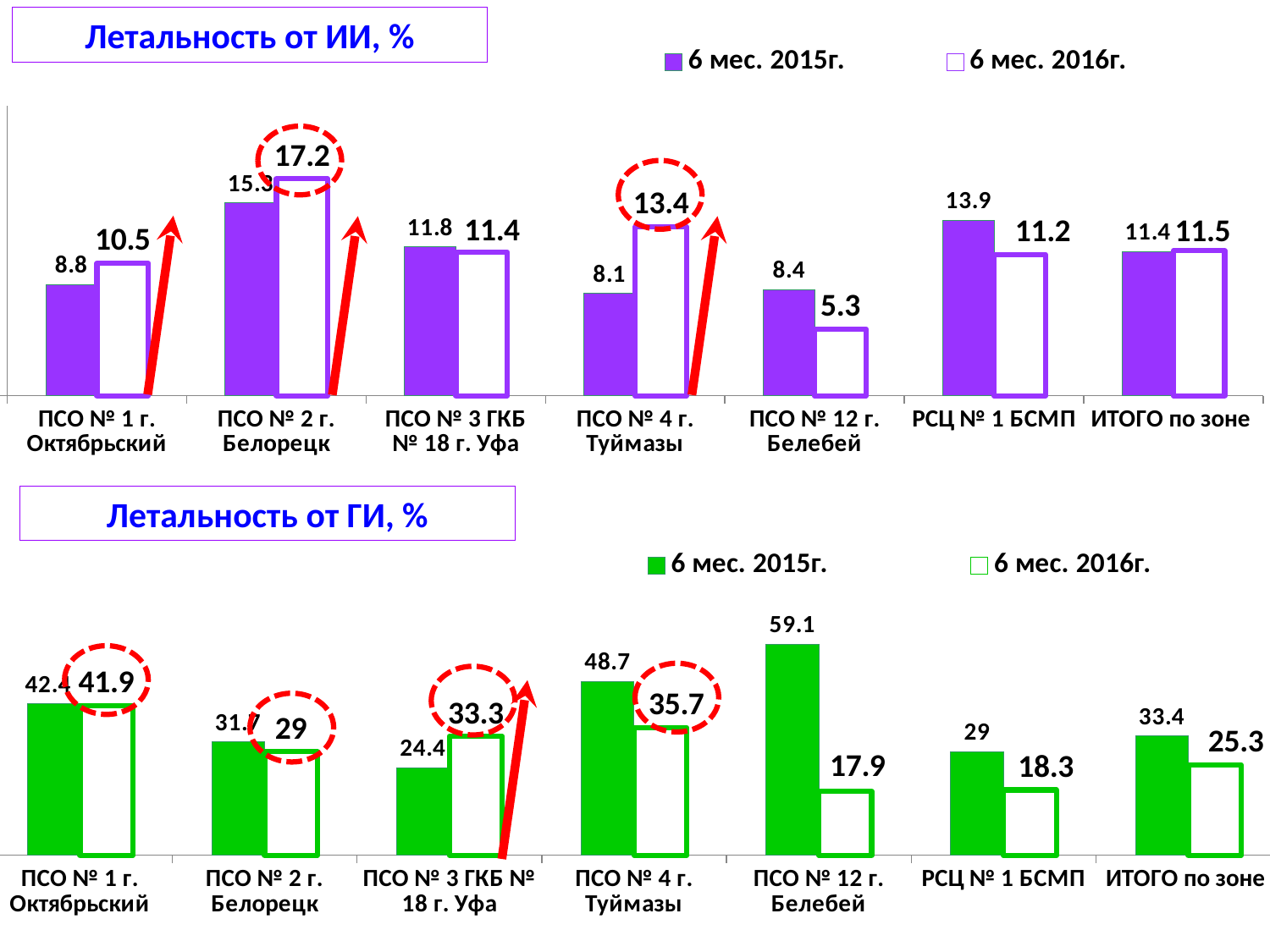
In the chart 'Летальность от ИИ, %', what is the value for РСЦ № 1 БСМП for 6 мес. 2015г.? 13.9 In the chart 'Летальность от ГИ, %', what is the value for ПСО № 12 г. Белебей for 6 мес. 2015г.? 59.1 In the chart 'Летальность от ИИ, %', how many series does the legend list? 2 What type of chart is 'Летальность от ГИ, %'? bar chart In the chart 'Летальность от ИИ, %', which category has the highest value for 6 мес. 2016г.? ПСО № 2 г. Белорецк In the chart 'Летальность от ИИ, %', which category has the lowest value for 6 мес. 2016г.? ПСО № 12 г. Белебей In the chart 'Летальность от ГИ, %', which category has the highest value for 6 мес. 2015г.? ПСО № 12 г. Белебей In the chart 'Летальность от ГИ, %', what is the value for ИТОГО по зоне for 6 мес. 2016г.? 25.3 In the chart 'Летальность от ИИ, %', what is the value for ПСО № 4 г. Туймазы for 6 мес. 2016г.? 13.4 In the chart 'Летальность от ГИ, %', is the 6 мес. 2016г. value for ПСО № 3 ГКБ № 18 г. Уфа larger or smaller than its 6 мес. 2015г. value? larger In the chart 'Летальность от ИИ, %', what is the difference between the 6 мес. 2016г. and 6 мес. 2015г. values for ПСО № 4 г. Туймазы? 5.3 In the chart 'Летальность от ГИ, %', how many categories are shown on the x axis? 7